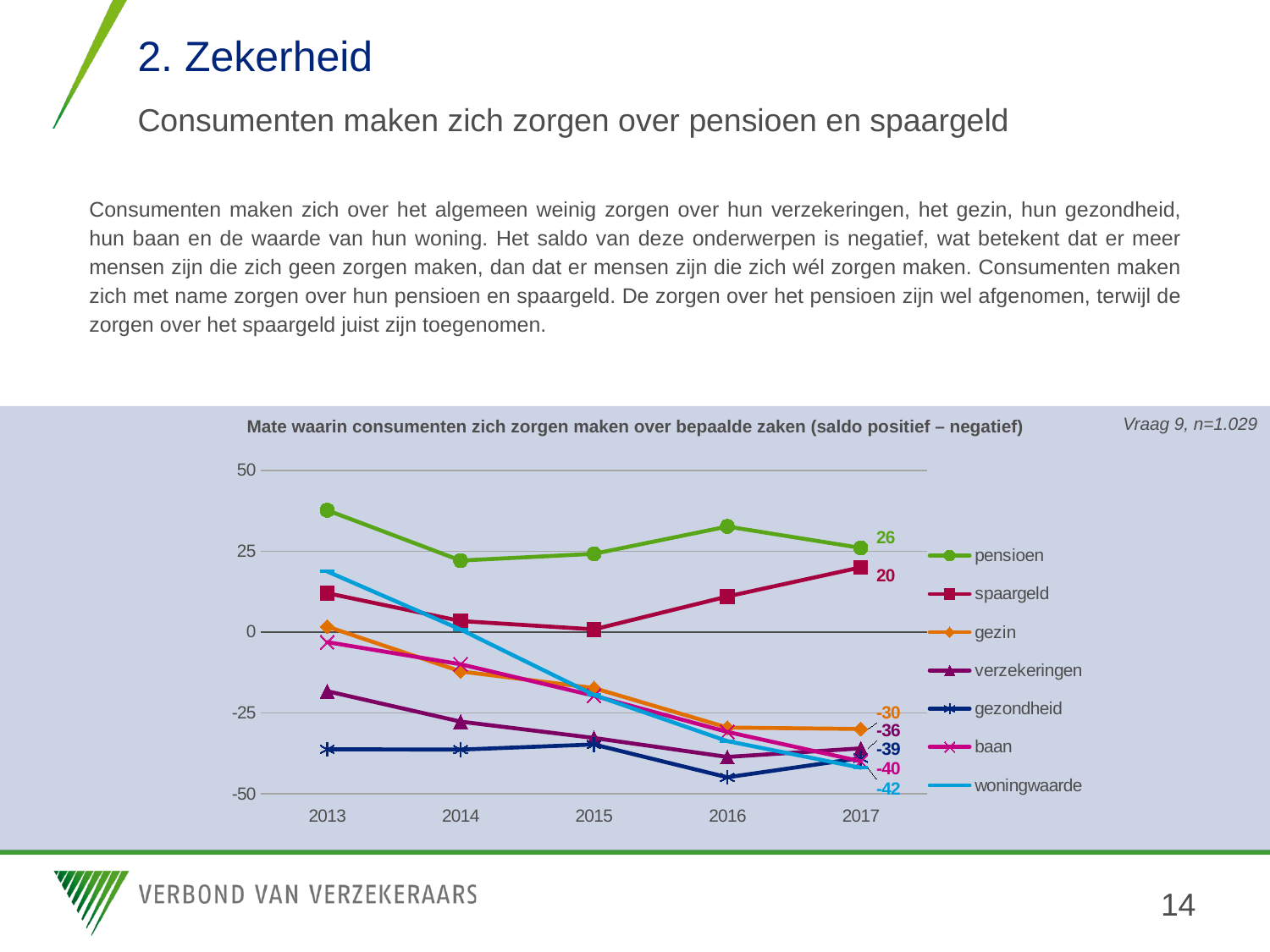
What is the difference between pensioen and spaargeld in 2017? 6 Is the value for pensioen in 2013 greater or less than 25? greater Does the woningwaarde line rise or fall from 2013 to 2017? fall What is the value for gezin in 2017? -30 What is the value for pensioen in 2017? 26 What type of chart is shown on the slide? line chart What is the value for spaargeld in 2017? 20 How many years are shown on the x axis? 5 What is the value for woningwaarde in 2017? -42 How many series does the legend list? 7 Which series has the highest value in 2017? pensioen Which series has the lowest value in 2017? woningwaarde